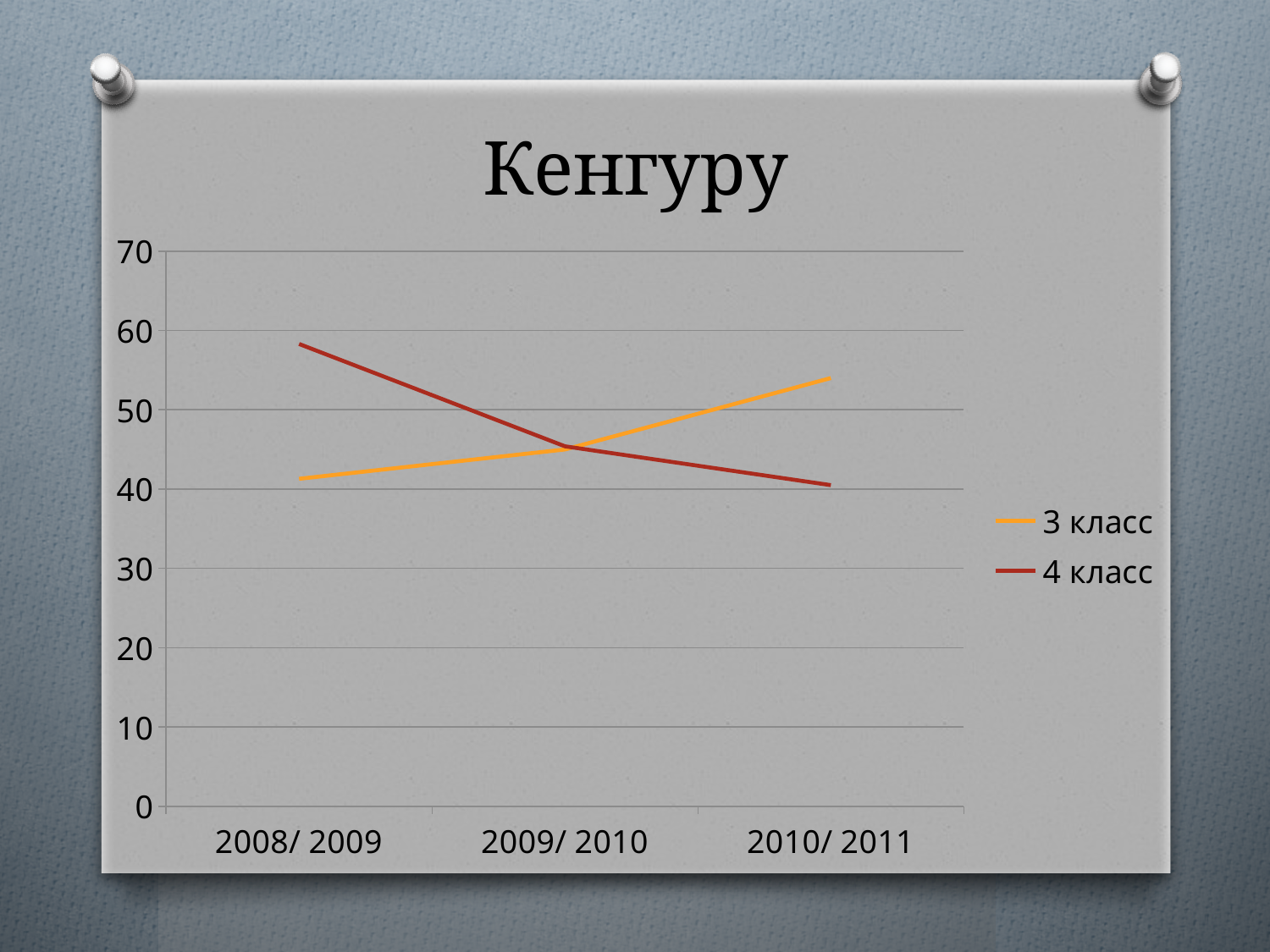
In which school year is the value for 4 класс highest? 2008/ 2009 Does the value for 4 класс rise or fall from 2008/ 2009 to 2010/ 2011? fall How many school years are shown on the x axis? 3 In 2010/ 2011, which series has the larger value, 3 класс or 4 класс? 3 класс Which series is drawn in red? 4 класс What kind of chart is shown on the slide? line chart Does the value for 3 класс rise or fall from 2008/ 2009 to 2010/ 2011? rise Is the value for 3 класс in 2010/ 2011 greater or less than 50? greater In 2008/ 2009, which series has the larger value, 3 класс or 4 класс? 4 класс What is the title of the chart? Кенгуру How many series does the legend list? 2 Is the value for 4 класс in 2008/ 2009 greater or less than 50? greater